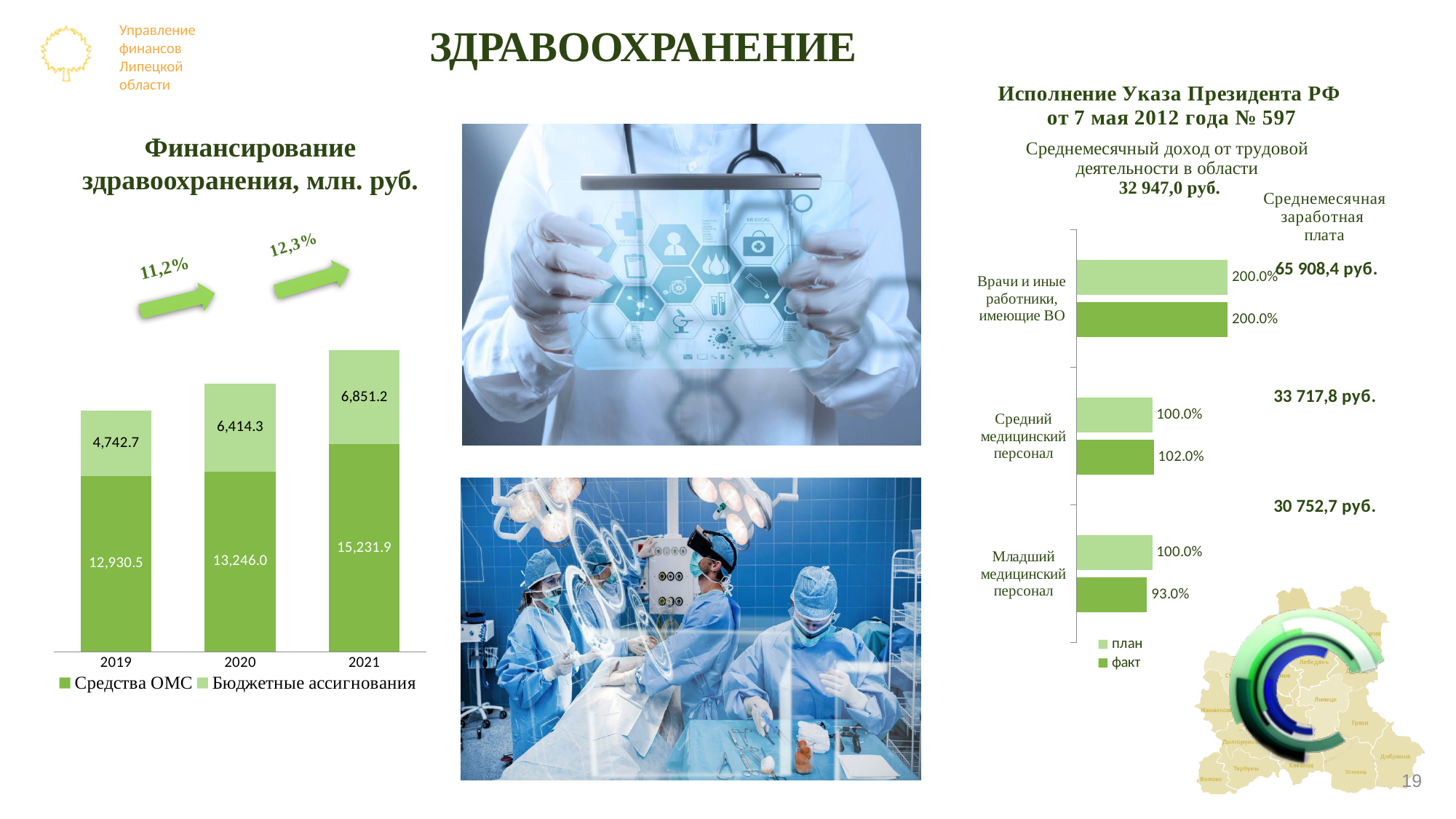
In the chart 'Исполнение Указа Президента РФ от 7 мая 2012 года № 597', what is the факт value for Младший медицинский персонал? 93.0% In the chart 'Финансирование здравоохранения, млн. руб.', what is the value of Средства ОМС for 2021? 15,231.9 In the chart 'Исполнение Указа Президента РФ от 7 мая 2012 года № 597', how many categories are shown? 3 In the chart 'Финансирование здравоохранения, млн. руб.', what is the difference between Средства ОМС in 2021 and in 2020? 1,985.9 In the chart 'Финансирование здравоохранения, млн. руб.', which year has the highest value of Средства ОМС? 2021 In the chart 'Исполнение Указа Президента РФ от 7 мая 2012 года № 597', what is the факт value for Средний медицинский персонал? 102.0% In the chart 'Исполнение Указа Президента РФ от 7 мая 2012 года № 597', which category has the lowest факт value? Младший медицинский персонал In the chart 'Финансирование здравоохранения, млн. руб.', what is the total of the stacked bar for 2020? 19,660.3 In the chart 'Финансирование здравоохранения, млн. руб.', how many series does the legend list? 2 In the chart 'Финансирование здравоохранения, млн. руб.', do the values of Бюджетные ассигнования rise or fall from 2019 to 2021? rise In the chart 'Финансирование здравоохранения, млн. руб.', what is the value of Бюджетные ассигнования for 2019? 4,742.7 What kind of chart is 'Финансирование здравоохранения, млн. руб.'? stacked bar chart